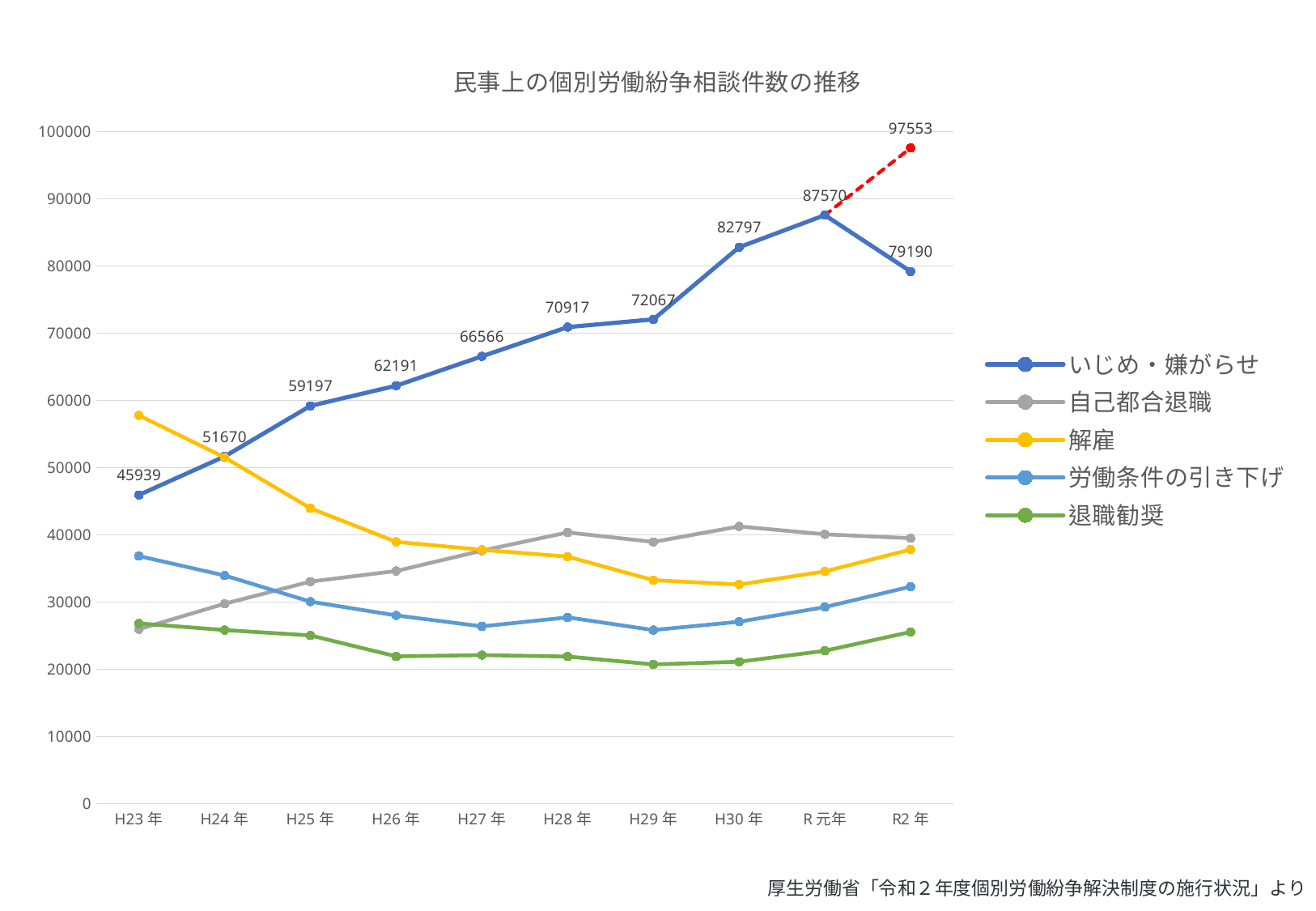
In H23年, which is larger: いじめ・嫌がらせ or 解雇? 解雇 Does the いじめ・嫌がらせ line rise or fall from H23年 to R元年? rise What is the difference between the いじめ・嫌がらせ values in R元年 (87570) and R2年 (79190)? 8380 How many years are shown along the x axis? 10 What is the value for いじめ・嫌がらせ in H23年? 45939 What is the value for いじめ・嫌がらせ in H30年? 82797 What is the value for いじめ・嫌がらせ in R2年 on the solid blue line? 79190 How many series does the legend list? 5 What kind of chart is shown on the slide? line chart In which year does the solid いじめ・嫌がらせ line reach its highest labelled value? R元年 Is the value for 退職勧奨 in H29年 greater or less than 30000? less What value is labelled at the end of the red dashed line in R2年? 97553